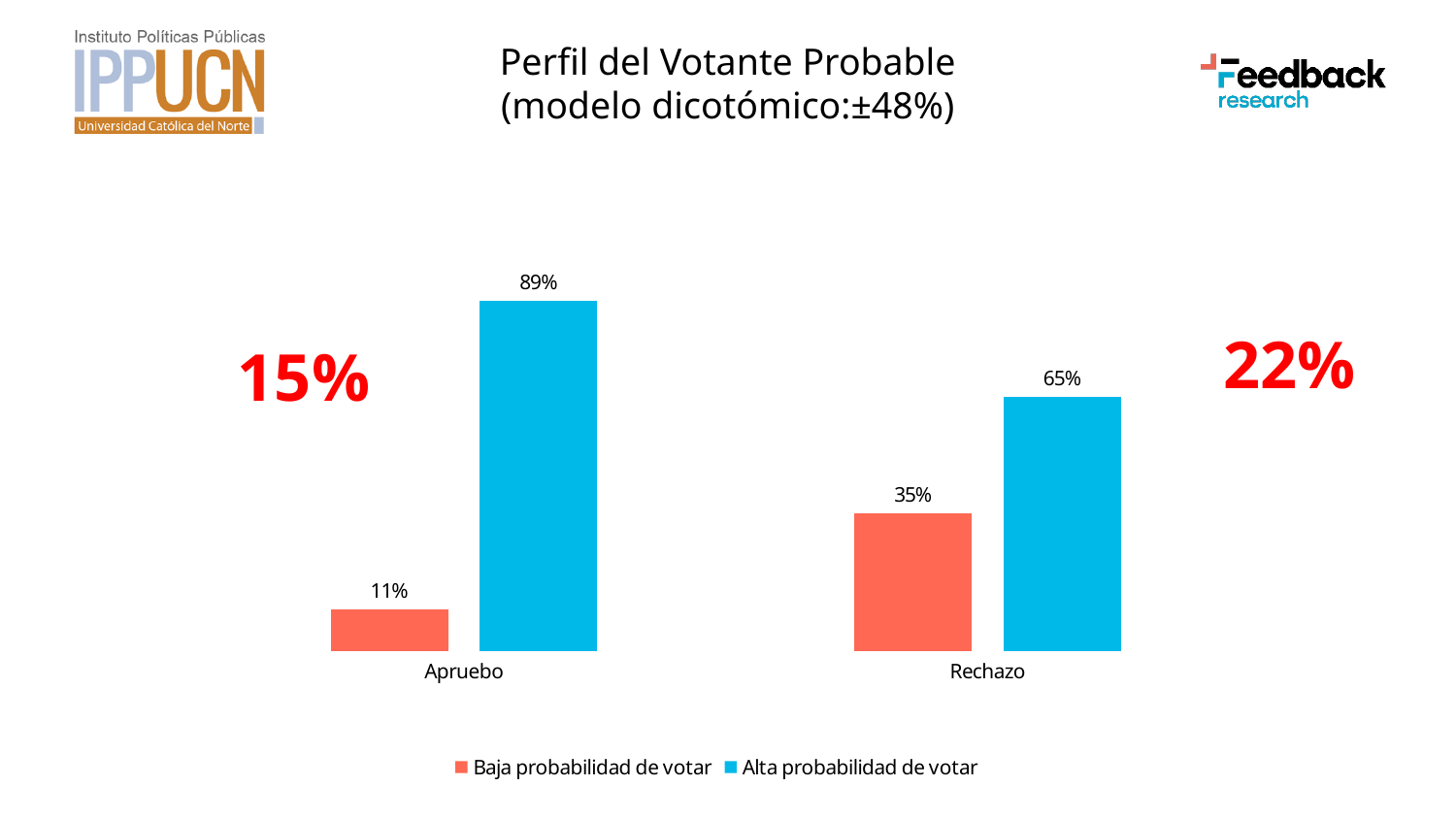
What is the value for 'Alta probabilidad de votar' in the Apruebo category? 89% What is the value for 'Baja probabilidad de votar' in the Apruebo category? 11% What is the difference between the 'Alta probabilidad de votar' values for Apruebo and Rechazo? 24% How many categories are shown on the x axis? 2 What kind of chart is shown on the slide? Bar chart What is the value for 'Alta probabilidad de votar' in the Rechazo category? 65% Which bar has the lowest value on the chart? Baja probabilidad de votar, Apruebo How many series does the legend list? 2 What is the title of the chart? Perfil del Votante Probable (modelo dicotómico:±48%) Which bar has the highest value on the chart? Alta probabilidad de votar, Apruebo Which is larger: 'Baja probabilidad de votar' for Apruebo or for Rechazo? Rechazo What is the value for 'Baja probabilidad de votar' in the Rechazo category? 35%